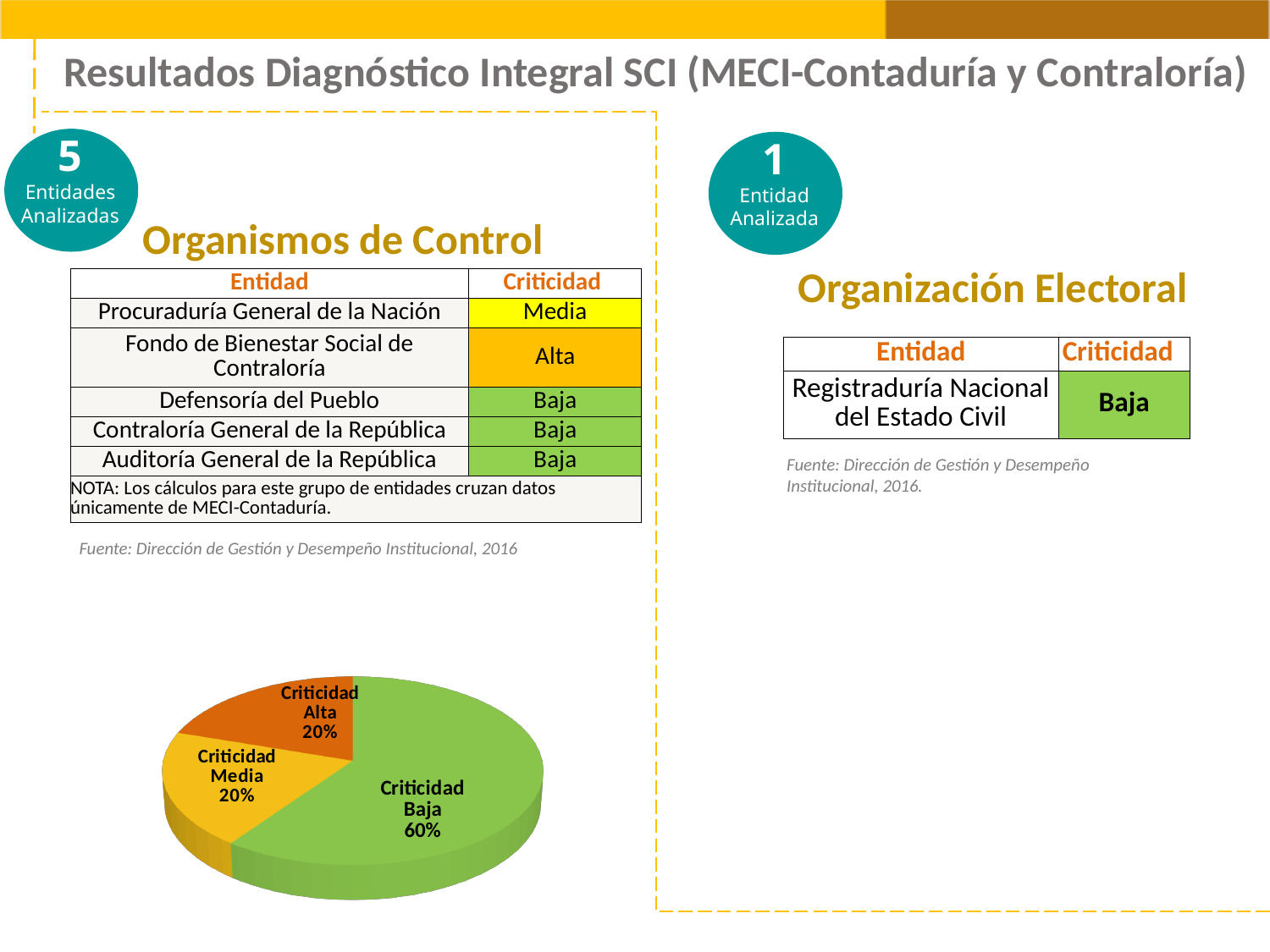
What kind of chart is shown at the bottom of the slide? Pie chart Which is larger in the pie chart, Criticidad Baja or Criticidad Media? Criticidad Baja How many slices does the pie chart have? 3 What colour is the Criticidad Baja slice in the pie chart? Green Do Criticidad Media and Criticidad Alta have the same share in the pie chart? Yes, both 20% What share of the pie chart does Criticidad Media represent? 20% What share of the pie chart does Criticidad Alta represent? 20% Which slice of the pie chart is the largest? Criticidad Baja What is the difference in percentage points between Criticidad Baja and Criticidad Alta in the pie chart? 40 percentage points What colour is the Criticidad Alta slice in the pie chart? Orange What share of the pie chart does Criticidad Baja represent? 60%